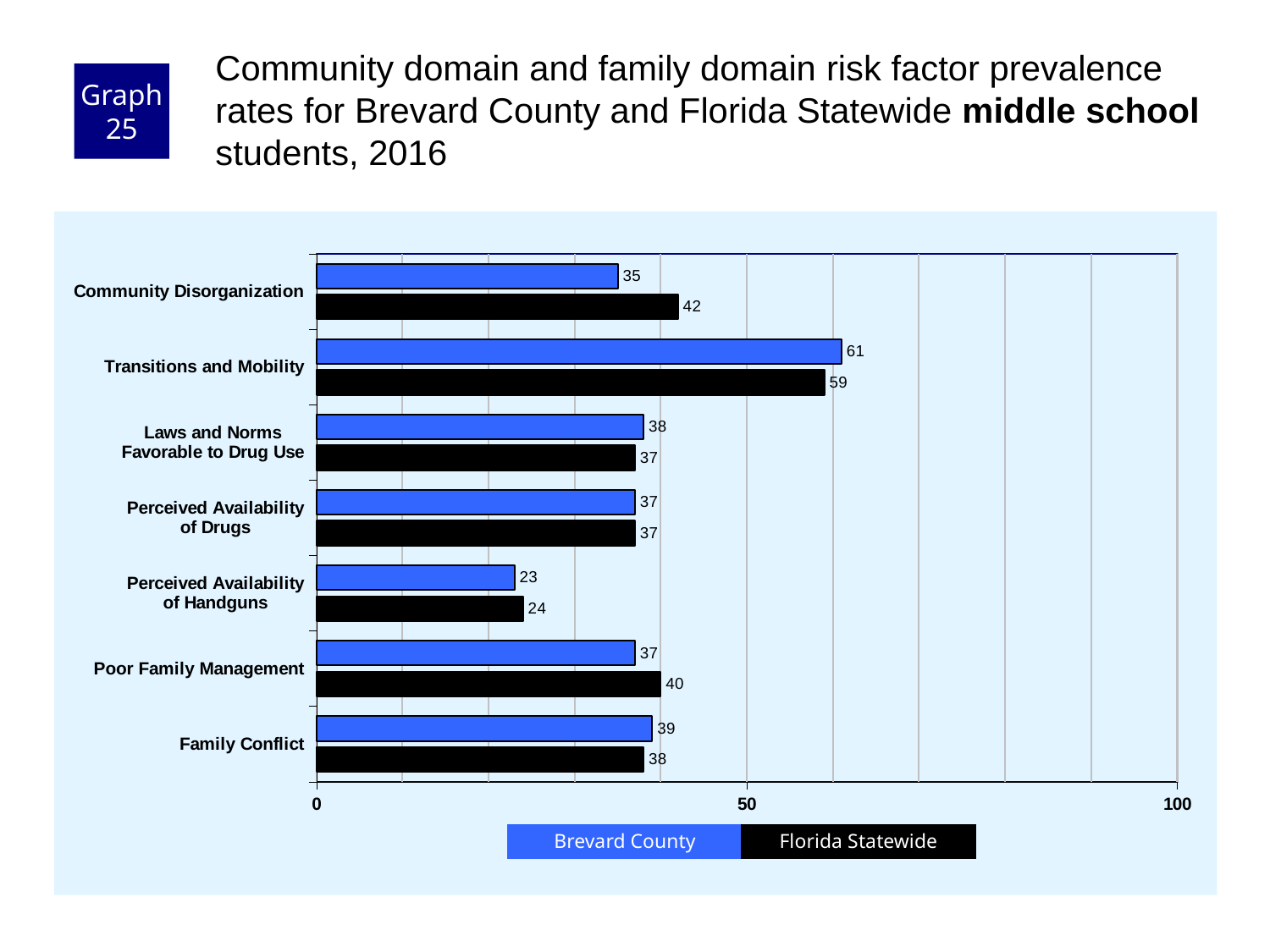
Is the Brevard County value for Transitions and Mobility greater or less than 50? greater How many series does the legend list? 2 What is the Florida Statewide value for Poor Family Management? 40 For Transitions and Mobility, which is larger: the Brevard County value or the Florida Statewide value? Brevard County What is the Florida Statewide value for Transitions and Mobility? 59 What is the Brevard County value for Community Disorganization? 35 Which risk factor has the lowest Florida Statewide value? Perceived Availability of Handguns What is the difference between the Florida Statewide and Brevard County values for Community Disorganization? 7 What kind of chart is shown on the slide? Bar chart What is the Brevard County value for Perceived Availability of Handguns? 23 How many risk factor categories are shown on the chart? 7 Which risk factor has the highest Brevard County value? Transitions and Mobility